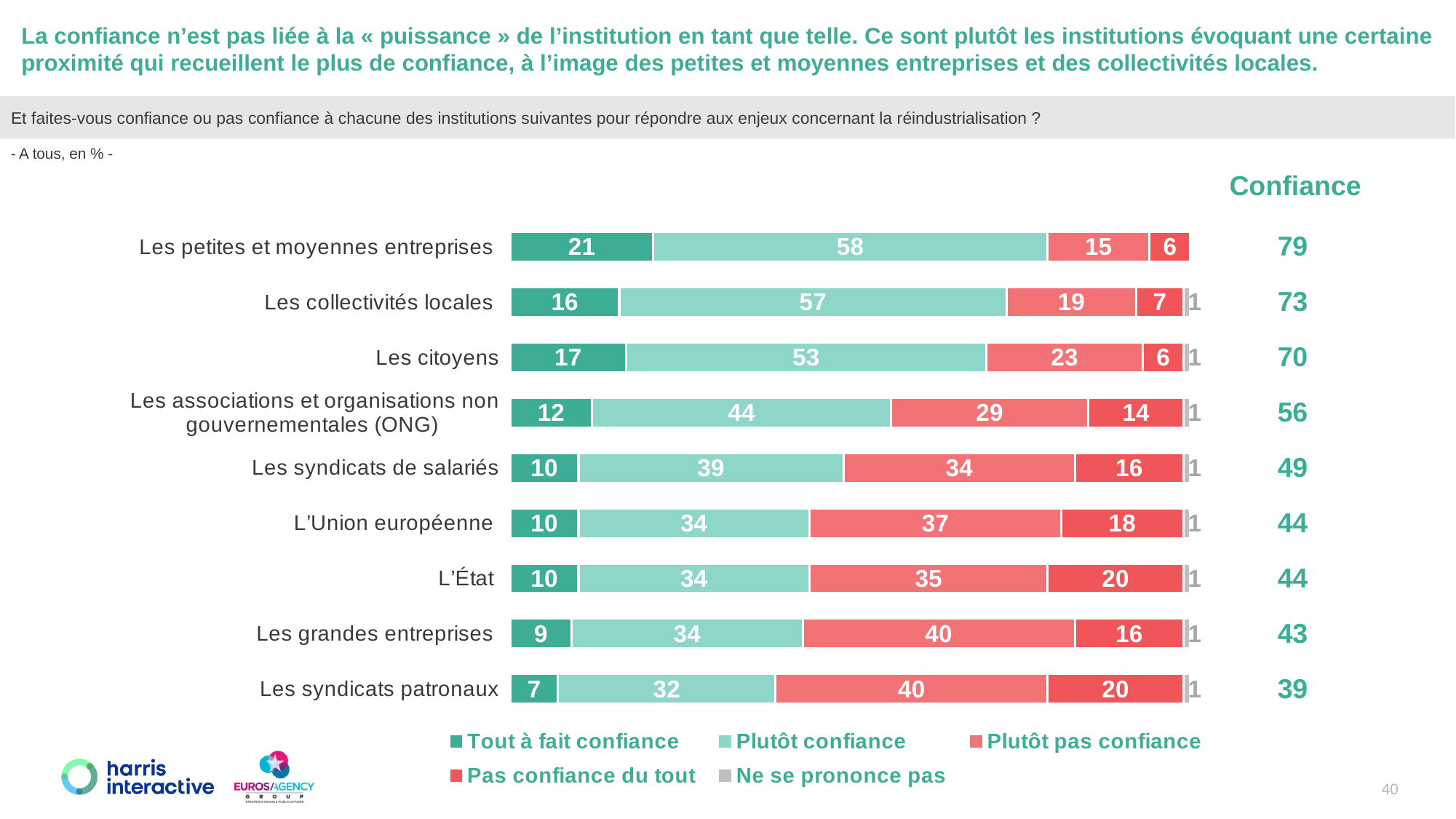
How many institutions are shown in the chart? 9 What is the difference between the "Plutôt confiance" values for Les petites et moyennes entreprises and Les syndicats patronaux? 26 What is the value of "Plutôt confiance" for Les petites et moyennes entreprises? 58 How many series does the legend list? 5 Which institution has the highest "Tout à fait confiance" value? Les petites et moyennes entreprises What kind of chart is shown on the slide? Stacked bar chart What is the combined total of "Tout à fait confiance" and "Plutôt confiance" for Les collectivités locales? 73 What is the value of "Pas confiance du tout" for L'État? 20 Which institution has the lowest "Tout à fait confiance" value? Les syndicats patronaux Which has a larger "Plutôt pas confiance" value, L'Union européenne or L'État? L'Union européenne What is the value of "Tout à fait confiance" for Les citoyens? 17 What is the value of "Plutôt pas confiance" for Les grandes entreprises? 40